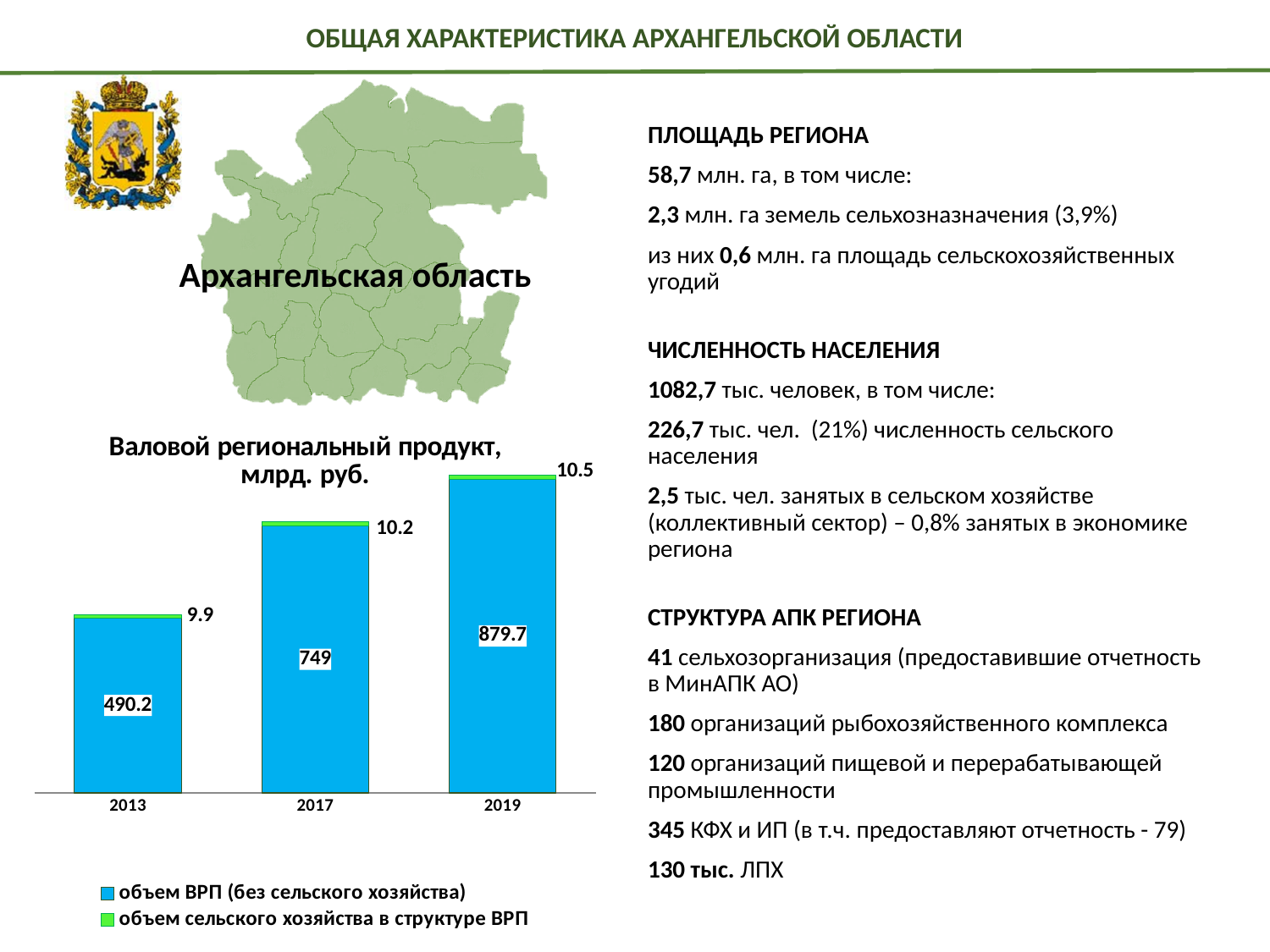
What is the value of объем сельского хозяйства в структуре ВРП for 2019? 10.5 What kind of chart is used to show the gross regional product? Stacked bar chart What is the difference between объем ВРП (без сельского хозяйства) in 2019 and in 2013? 389.5 How many years are shown on the x axis of the chart? 3 Which year has the highest value of объем ВРП (без сельского хозяйства)? 2019 Which year has the lowest value of объем сельского хозяйства в структуре ВРП? 2013 What is the total of the stacked bar for 2019? 890.2 What is the value of объем ВРП (без сельского хозяйства) for 2013? 490.2 Which is larger: объем ВРП (без сельского хозяйства) in 2017 or in 2013? 2017 What is the difference between объем сельского хозяйства в структуре ВРП in 2019 and in 2013? 0.6 What is the value of объем ВРП (без сельского хозяйства) for 2017? 749 How many series does the chart legend list? 2